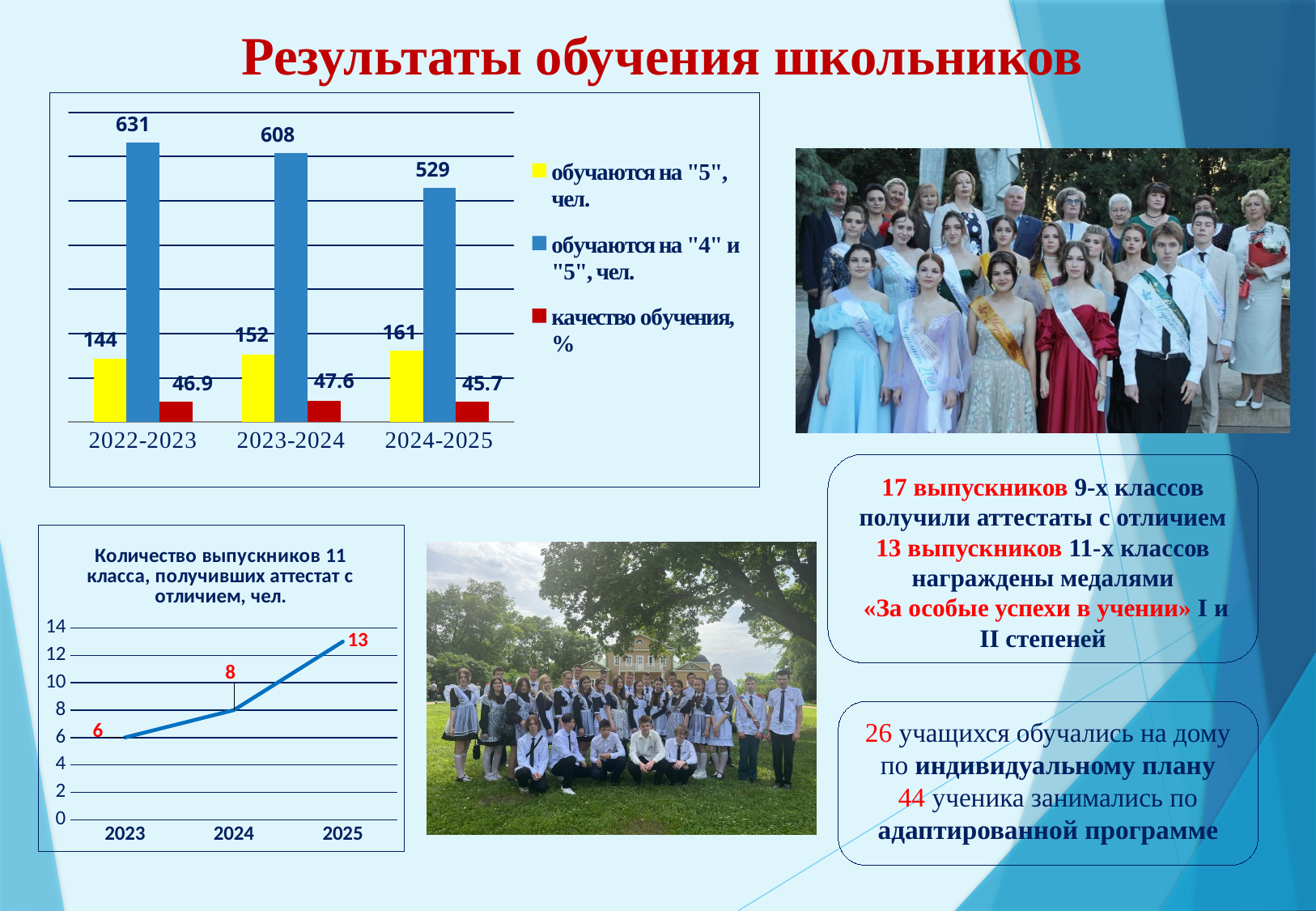
In the top-left bar chart, which school year has the highest value for "обучаются на "5", чел."? 2024-2025 In the top-left bar chart, what is the difference between the "обучаются на "4" и "5", чел." values for 2022-2023 and 2024-2025? 102 In the top-left bar chart, which school year has the lowest value for "обучаются на "4" и "5", чел."? 2024-2025 In the top-left bar chart, how many series does the legend list? 3 In the top-left bar chart, what is the value for "качество обучения, %" in 2023-2024? 47.6 In the chart titled "Количество выпускников 11 класса, получивших аттестат с отличием, чел.", what is the difference between the values for 2025 and 2023? 7 In the top-left bar chart, does the value for "обучаются на "4" и "5", чел." rise or fall from 2022-2023 to 2024-2025? fall In the top-left bar chart, what is the value for "обучаются на "5", чел." in 2024-2025? 161 In the chart titled "Количество выпускников 11 класса, получивших аттестат с отличием, чел.", how many years are plotted on the x axis? 3 In the top-left bar chart, what is the value for "обучаются на "4" и "5", чел." in 2022-2023? 631 In the chart titled "Количество выпускников 11 класса, получивших аттестат с отличием, чел.", what is the value for 2024? 8 What kind of chart is the one titled "Количество выпускников 11 класса, получивших аттестат с отличием, чел."? line chart